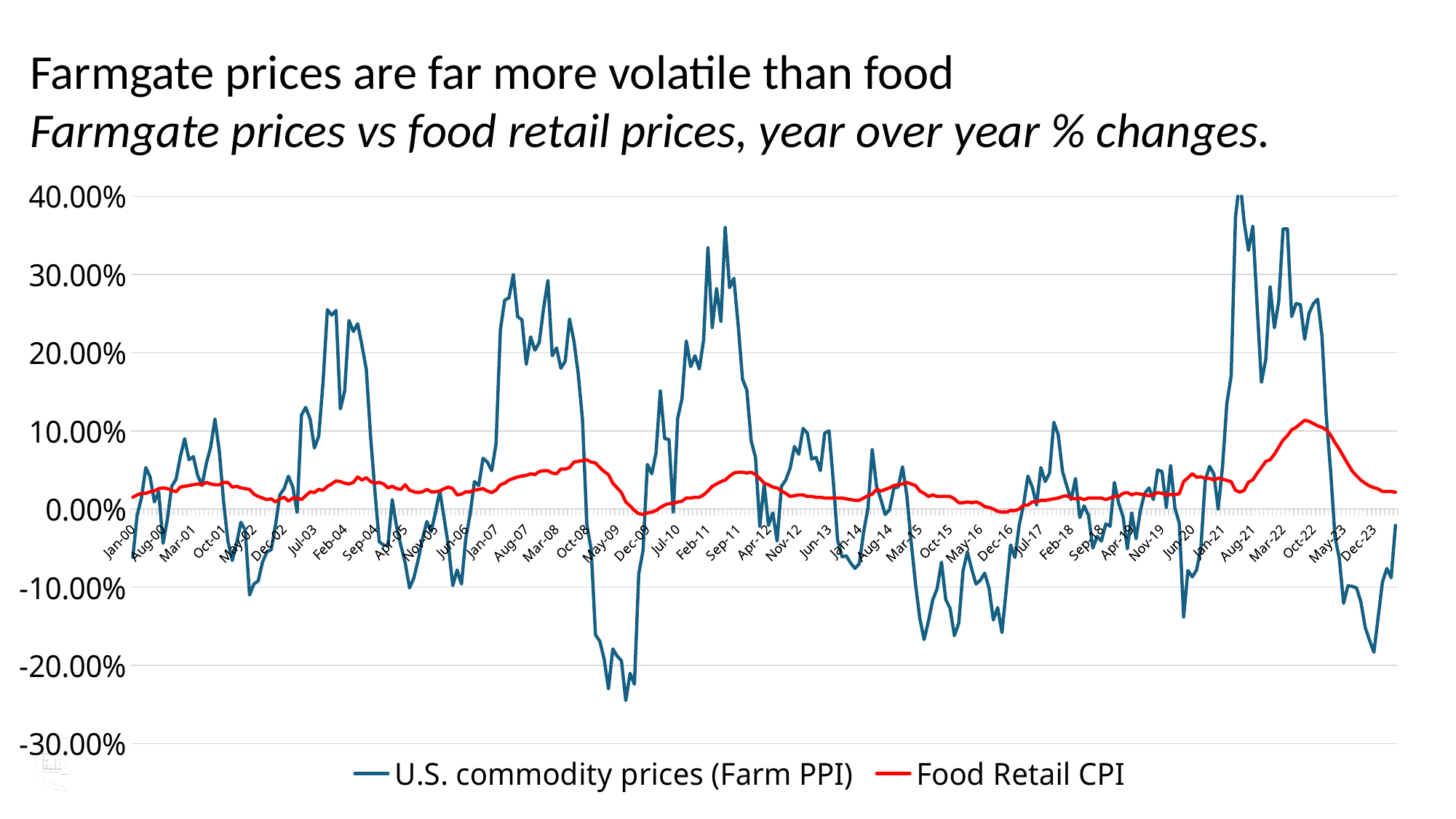
Is the value of Food Retail CPI around Jan-00 greater or less than 10.00%? less What is the chart's subtitle (the italic line under the main title)? Farmgate prices vs food retail prices, year over year % changes. Is the peak value of Food Retail CPI around Oct-22 greater or less than 10.00%? greater Does the Food Retail CPI series rise or fall between Oct-22 and Dec-23? fall Is the peak value of U.S. commodity prices (Farm PPI) around Aug-21 greater or less than 30.00%? greater What is the highest value shown on the vertical axis? 40.00% Which series reaches the higher peak value over the whole period, U.S. commodity prices (Farm PPI) or Food Retail CPI? U.S. commodity prices (Farm PPI) Around Aug-21, which series has the higher value, U.S. commodity prices (Farm PPI) or Food Retail CPI? U.S. commodity prices (Farm PPI) What are the two series named in the legend? U.S. commodity prices (Farm PPI) and Food Retail CPI How many series does the legend list? 2 What kind of chart is shown on the slide? line chart